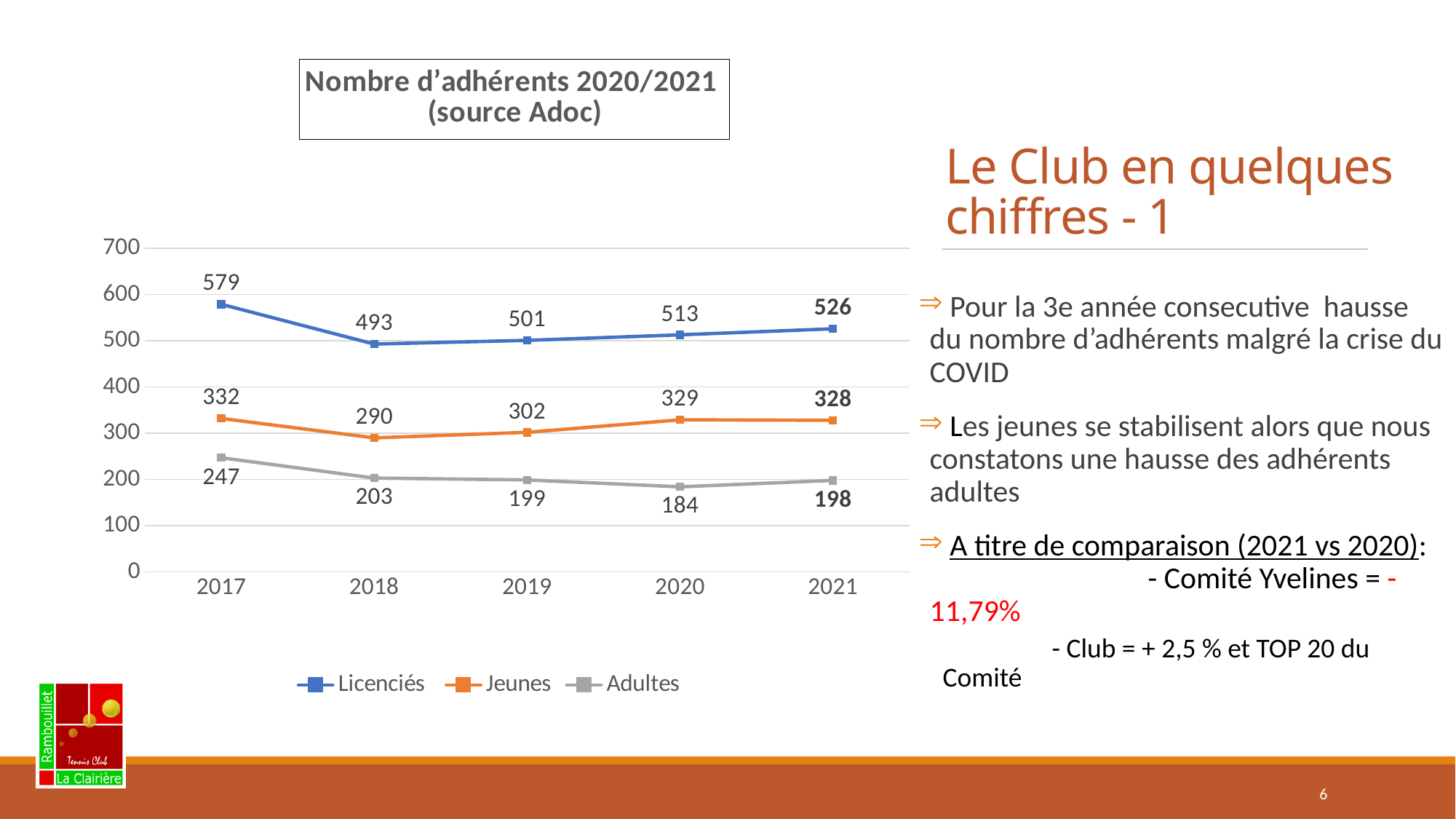
Does the Licenciés series rise or fall from 2018 to 2021? rise Which is larger, the Jeunes value in 2020 or in 2021? 2020 What is the difference between the Licenciés values in 2017 and 2018? 86 How many series does the legend list? 3 What is the value for Adultes in 2020? 184 What is the title of the chart? Nombre d’adhérents 2020/2021 (source Adoc) How many years are shown on the x axis? 5 What kind of chart is shown on the slide? line chart What is the value for Jeunes in 2018? 290 In which year is the Licenciés series highest? 2017 In which year is the Adultes series lowest? 2020 What is the value for Licenciés in 2021? 526